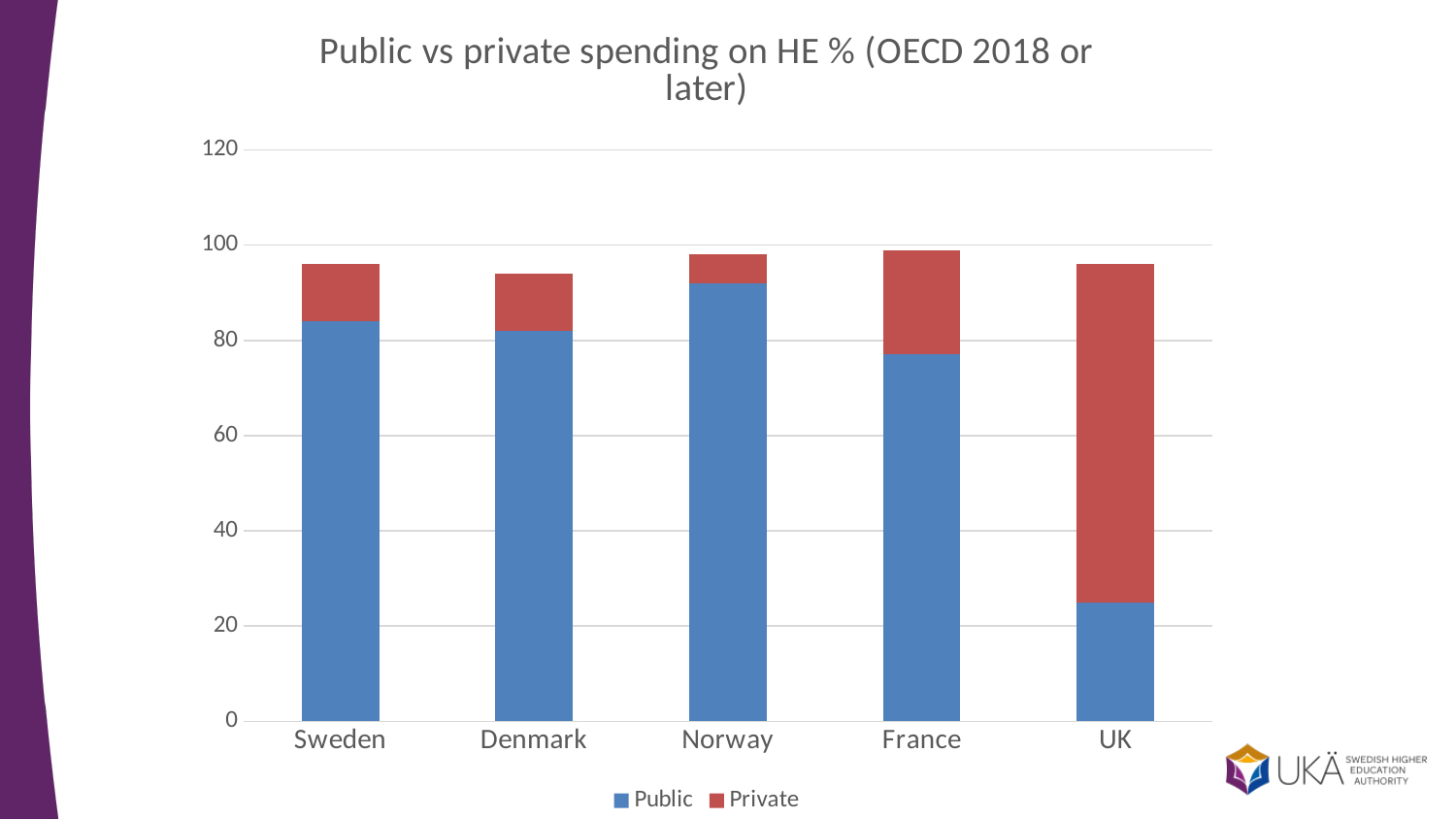
Which country has the lowest Public spending share in the chart? UK How many series does the chart's legend list? 2 How many countries are shown on the x axis of the chart? 5 What kind of chart is shown on the slide? Stacked bar chart What colour represents the Private series in the chart? Red Which country has the smallest Private spending share in the chart? Norway Which country has the highest Public spending share in the chart? Norway Is the Private value for the UK greater or less than 60? greater Which is larger, the Public value for Norway or the Public value for France? Norway Is the Public value for Norway greater or less than 80? greater Which country has the largest Private spending share in the chart? UK Is the Public value for the UK greater or less than 40? less